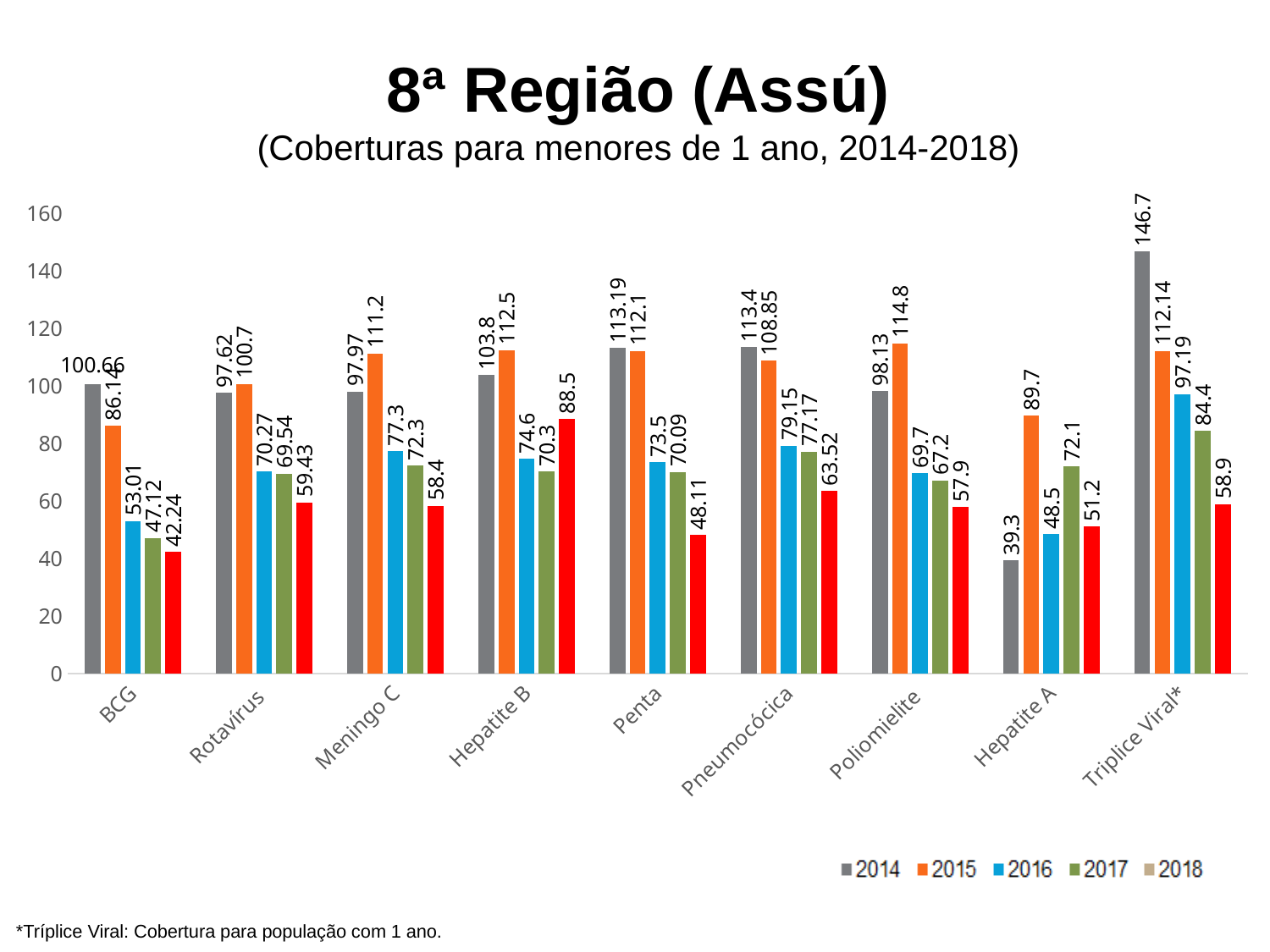
What is the difference between the 2014 and 2015 values for Tríplice Viral*? 34.56 Which is larger: the 2015 value for Poliomielite or the 2015 value for Hepatite B? Poliomielite What is the difference between the 2014 and 2018 values for Penta? 65.08 What is the 2014 coverage value for Tríplice Viral*? 146.7 How many vaccine categories are shown on the x axis? 9 What is the 2016 coverage value for Pneumocócica? 79.15 How many series does the legend list? 5 Do the BCG coverage values rise or fall from 2014 to 2018? Fall Which vaccine has the highest 2014 coverage value? Tríplice Viral* Which vaccine has the lowest 2014 coverage value? Hepatite A What is the 2018 coverage value for Hepatite B? 88.5 What kind of chart is shown on the slide? Bar chart